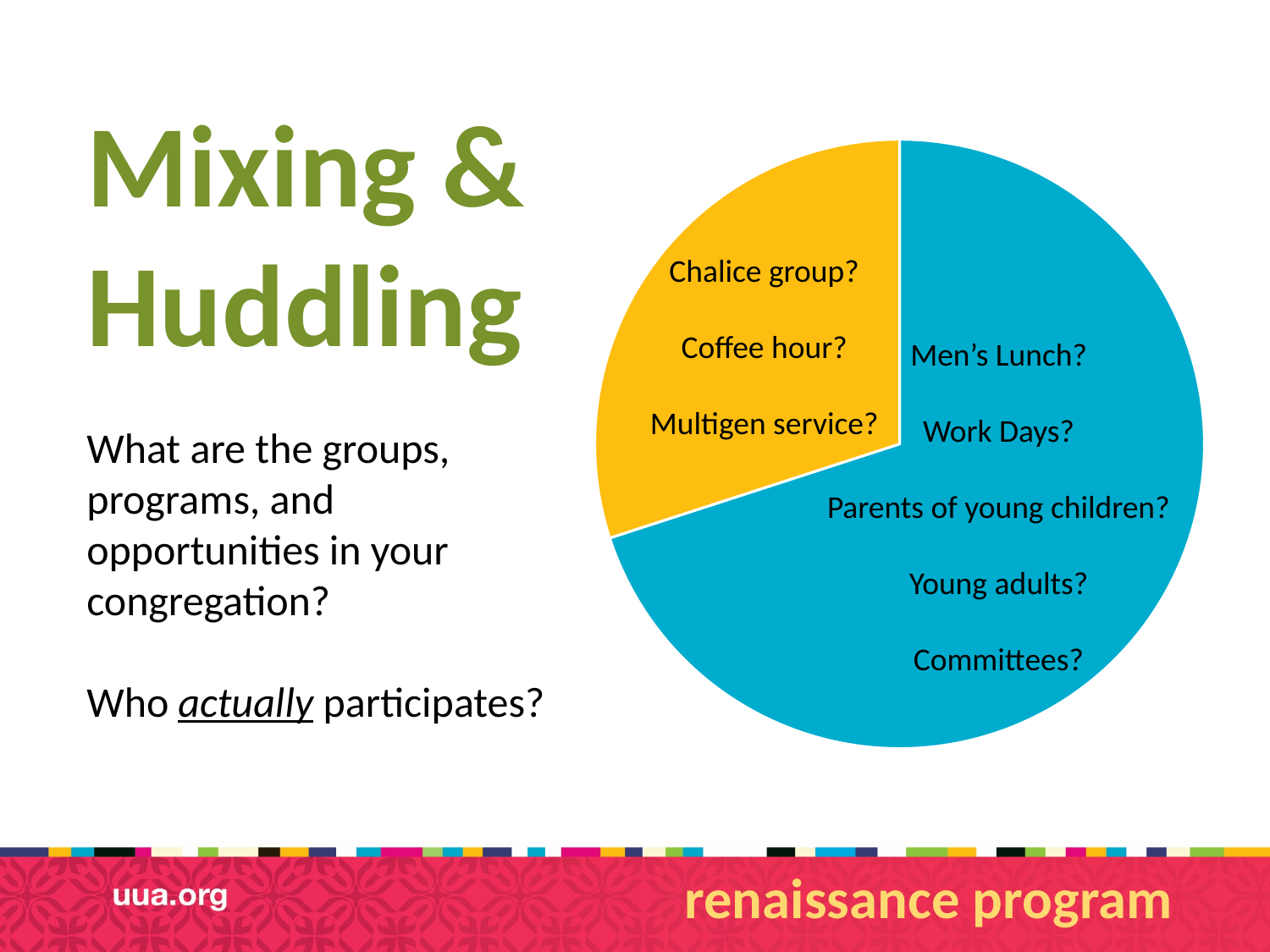
Which text labels appear inside the yellow slice of the pie chart? Chalice group?, Coffee hour?, Multigen service? How many slices does the pie chart have? 2 Which slice of the pie chart is the smallest? the yellow slice What kind of chart is shown on the slide? pie chart Is the yellow slice of the pie chart more or less than half of the pie? less Which slice of the pie chart is larger, the blue one or the yellow one? the blue one What two colours are used for the slices of the pie chart? blue and yellow Is the blue slice of the pie chart more or less than half of the pie? more Which slice of the pie chart is the largest? the blue slice